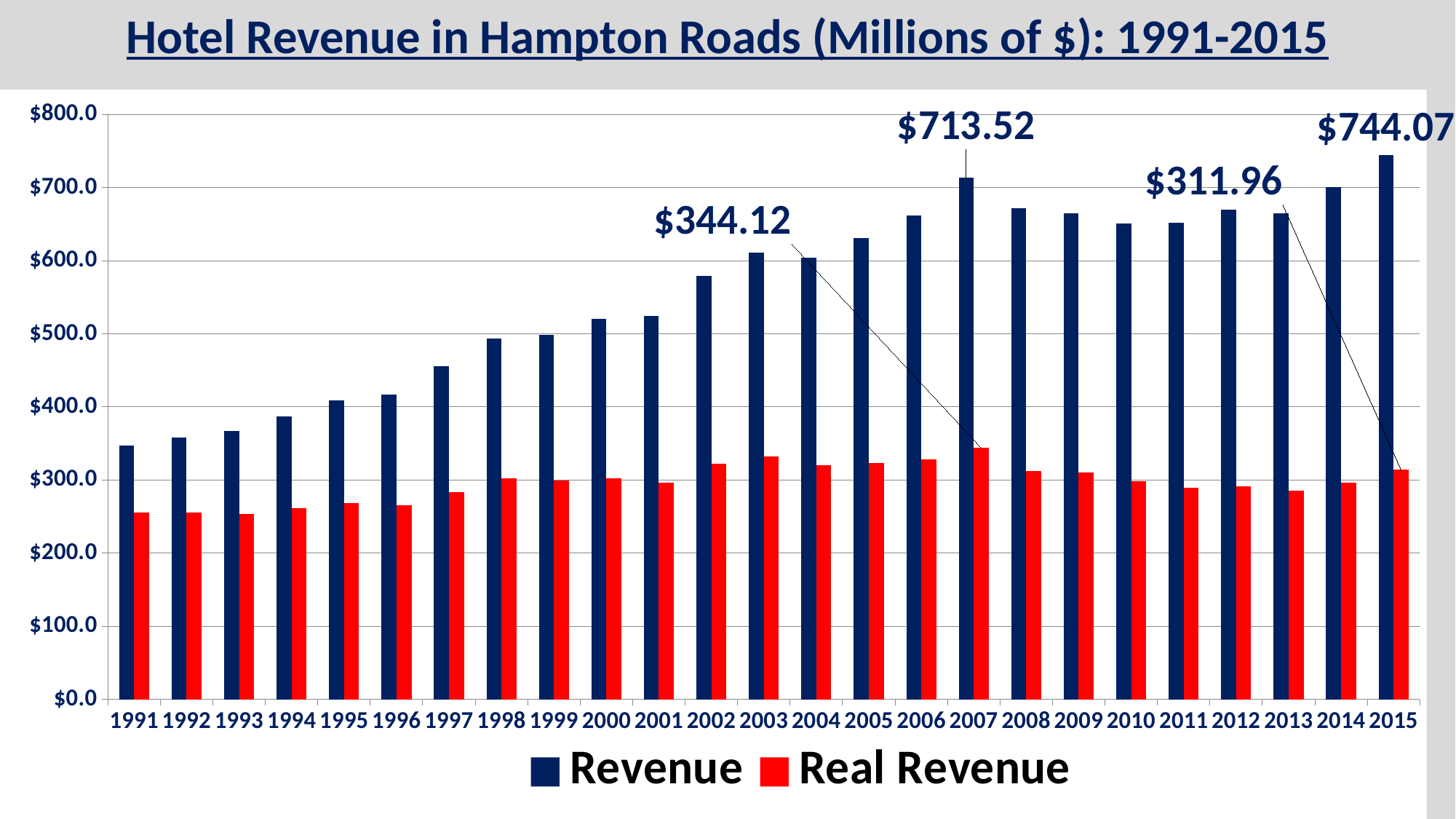
How much higher is Revenue in 2015 than in 2007? $30.55 What kind of chart is shown on the slide? Bar chart Is the Revenue value for 1991 greater or less than $400.0? less How many years are shown on the x axis? 25 What is the Revenue value for 2007? $713.52 How much lower is Real Revenue in 2015 than in 2007? $32.16 How many series does the legend list? 2 What is the Revenue value for 2015? $744.07 Which year has the highest Revenue? 2015 What is the Real Revenue value for 2015? $311.96 What is the Real Revenue value for 2007? $344.12 Does Revenue generally rise or fall from 1991 to 2007? Rise